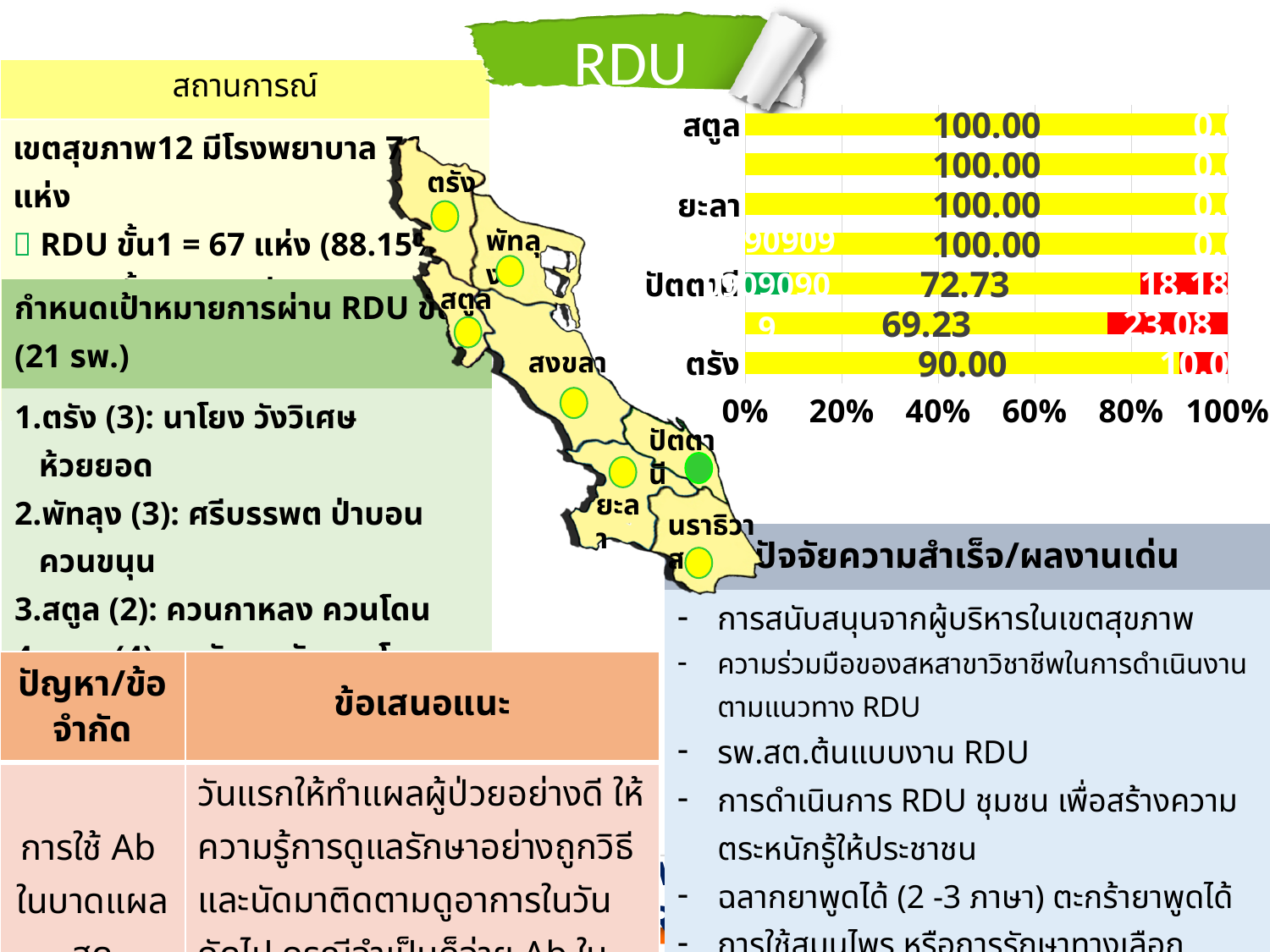
In the bar chart, what is the value printed on the yellow bar for สตูล? 100.00 What kind of chart is shown on the right side of the slide? bar chart Among the labeled provinces in the bar chart (สตูล, ยะลา, ปัตตานี, ตรัง), which has the lowest yellow segment value? ปัตตานี What is the range of the horizontal axis in the bar chart? 0% to 100% In the bar chart, what is the value printed on the yellow bar for ยะลา? 100.00 In the bar chart, what is the value printed on the red segment for ปัตตานี? 18.18 How many bars are plotted in the bar chart? 7 In the bar chart, what is the difference between the yellow segment values for ตรัง (90.00) and ปัตตานี (72.73)? 17.27 In the bar chart, what is the value printed on the yellow segment for ตรัง? 90.00 In the bar chart, which has the larger yellow segment value, ตรัง or ปัตตานี? ตรัง In the bar chart, what is the value printed on the yellow segment for ปัตตานี? 72.73 In the bar chart, is the yellow segment value for ปัตตานี greater or less than 60%? greater